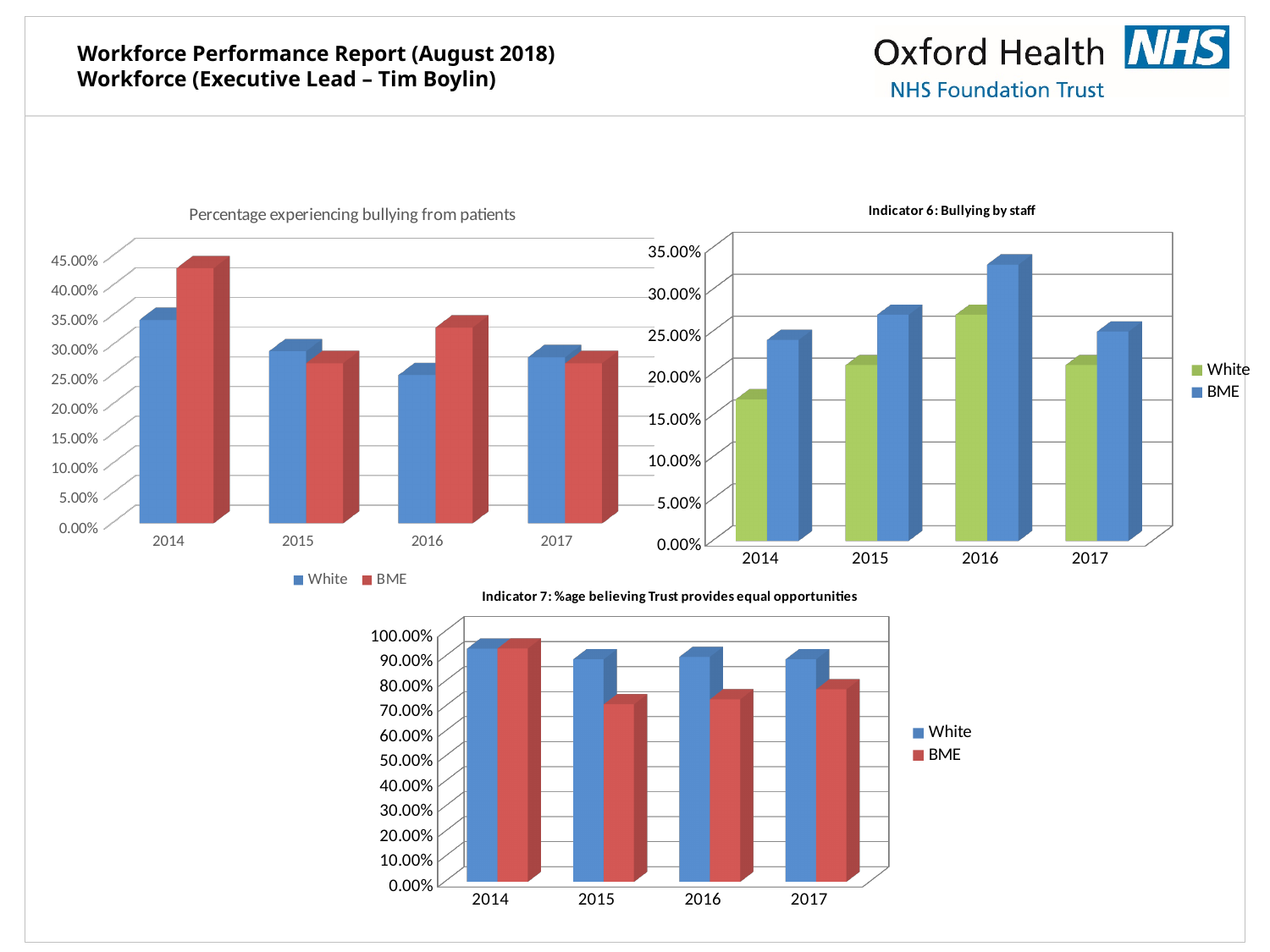
In the 'Indicator 6: Bullying by staff' chart, is the value for White in 2014 greater or less than 20.00%? less In the 'Indicator 7: %age believing Trust provides equal opportunities' chart, is the value for BME in 2015 greater or less than 80.00%? less How many series does the legend of the 'Indicator 6: Bullying by staff' chart list? 2 In the 'Percentage experiencing bullying from patients' chart, which series has the larger value in 2016, White or BME? BME In the 'Indicator 6: Bullying by staff' chart, which year has the highest value for BME? 2016 What kind of chart is the 'Indicator 7: %age believing Trust provides equal opportunities' chart? Bar chart In the 'Indicator 7: %age believing Trust provides equal opportunities' chart, which year has the lowest value for BME? 2015 In the 'Percentage experiencing bullying from patients' chart, which year has the highest value for BME? 2014 How many years are shown on the x axis of the 'Indicator 7: %age believing Trust provides equal opportunities' chart? 4 In the 'Indicator 6: Bullying by staff' chart, which year has the lowest value for White? 2014 In the 'Indicator 6: Bullying by staff' chart, what colour represents the White series? Green In the 'Percentage experiencing bullying from patients' chart, is the value for White in 2014 greater or less than 30.00%? greater